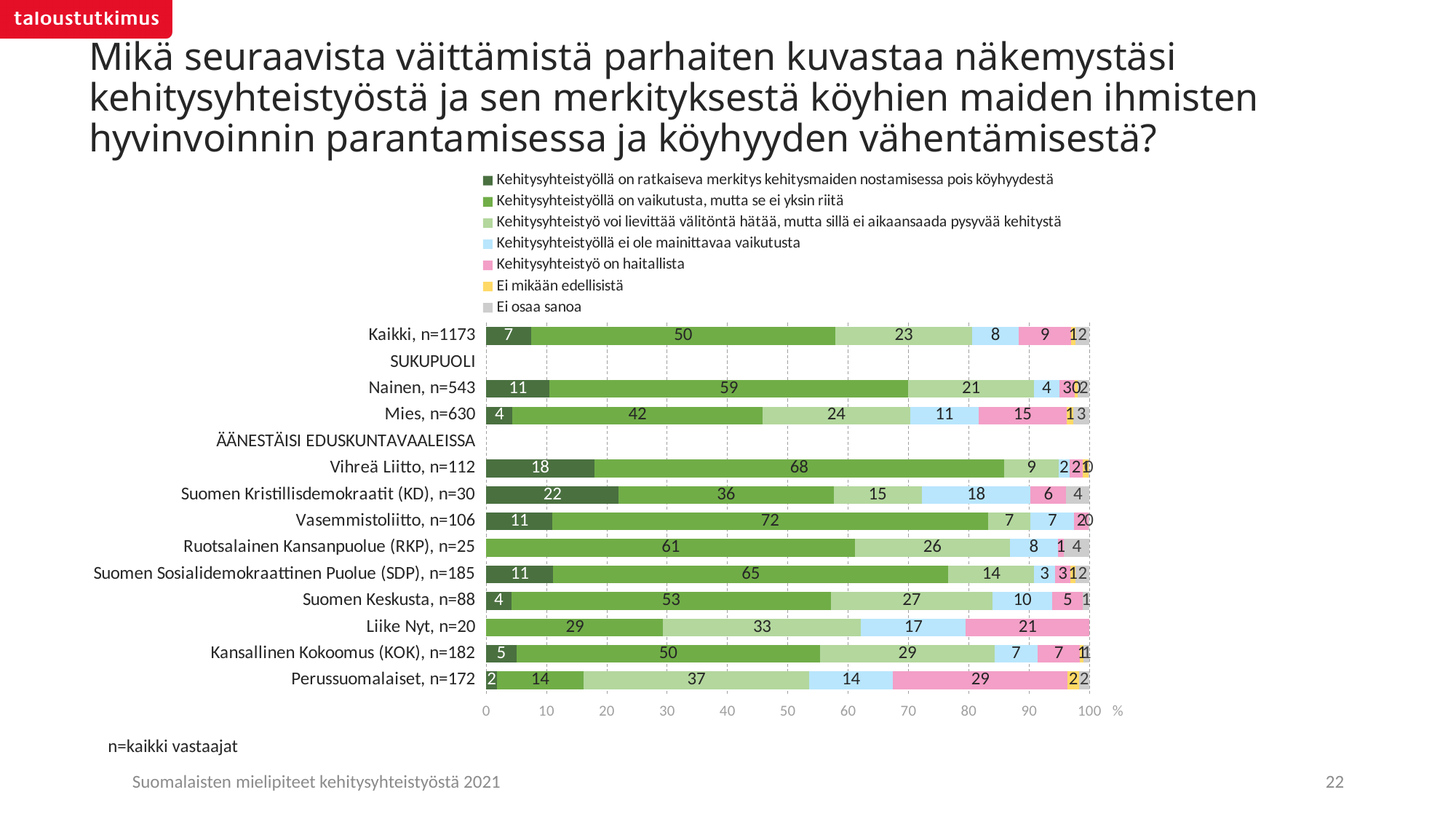
What is the value for 'Kehitysyhteistyöllä on ratkaiseva merkitys kehitysmaiden nostamisessa pois köyhyydestä' in the Vihreä Liitto, n=112 bar? 18 What is the value for 'Kehitysyhteistyöllä on vaikutusta, mutta se ei yksin riitä' in the Kaikki, n=1173 bar? 50 Which group has the highest value for 'Kehitysyhteistyöllä on ratkaiseva merkitys kehitysmaiden nostamisessa pois köyhyydestä'? Suomen Kristillisdemokraatit (KD), n=30 What is the value for 'Kehitysyhteistyöllä on vaikutusta, mutta se ei yksin riitä' in the Vasemmistoliitto, n=106 bar? 72 What is the value for 'Kehitysyhteistyö on haitallista' in the Perussuomalaiset, n=172 bar? 29 Which group has the highest value for 'Kehitysyhteistyöllä on vaikutusta, mutta se ei yksin riitä'? Vasemmistoliitto, n=106 How many series does the legend list? 7 What type of chart is shown on the slide? Stacked bar chart Which has the larger value for 'Kehitysyhteistyö on haitallista', Mies, n=630 or Nainen, n=543? Mies, n=630 How many bars (respondent groups) are plotted in the chart? 12 What is the value for 'Kehitysyhteistyöllä ei ole mainittavaa vaikutusta' in the Liike Nyt, n=20 bar? 17 What is the difference between Nainen, n=543 and Mies, n=630 for 'Kehitysyhteistyöllä on vaikutusta, mutta se ei yksin riitä'? 17